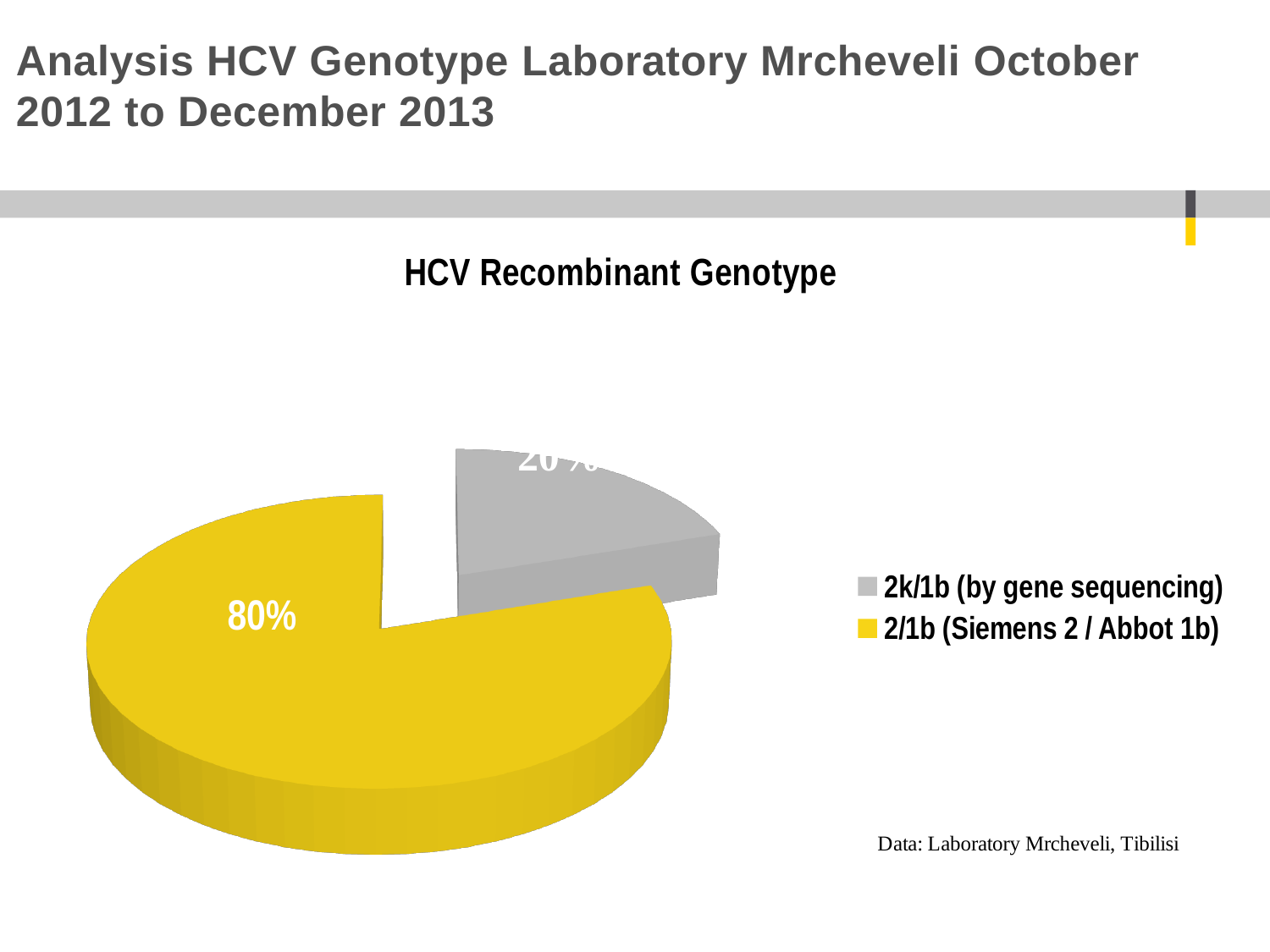
How many entries does the legend list? 2 What share of the pie does 2/1b (Siemens 2 / Abbot 1b) represent? 80% Which genotype has the largest share of the pie? 2/1b (Siemens 2 / Abbot 1b) Which genotype has the smallest share of the pie? 2k/1b (by gene sequencing) Is the share for 2k/1b (by gene sequencing) greater or less than 50%? less What kind of chart is shown on the slide? Pie chart How many slices does the pie chart have? 2 What is the title of the chart? HCV Recombinant Genotype What colour is the slice for 2/1b (Siemens 2 / Abbot 1b)? Yellow Which slice is larger: 2k/1b (by gene sequencing) or 2/1b (Siemens 2 / Abbot 1b)? 2/1b (Siemens 2 / Abbot 1b) Is the share for 2/1b (Siemens 2 / Abbot 1b) greater or less than 50%? greater